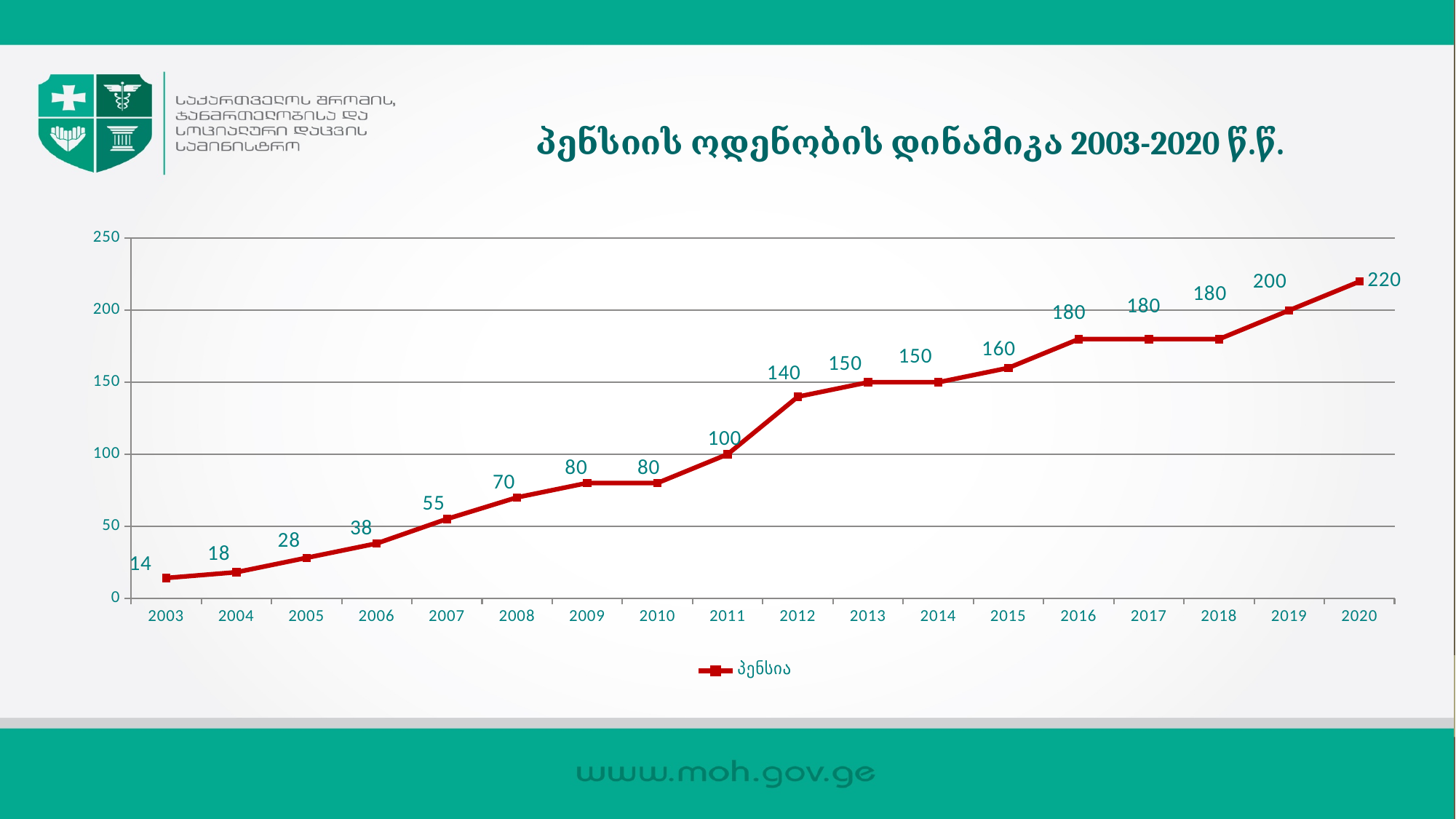
Which is larger, the value for 2008 or the value for 2010? 2010 What is the value for 2003? 14 Which year has the highest value? 2020 Which year has the lowest value? 2003 What is the value for 2020? 220 How many years are shown on the x axis? 18 What is the value for 2012? 140 Do the values generally rise or fall from 2003 to 2020? rise Is the value for 2015 greater or less than 150? greater What is the difference between the values for 2020 and 2003? 206 What kind of chart is shown on the slide? line chart What is the difference between the values for 2012 and 2011? 40